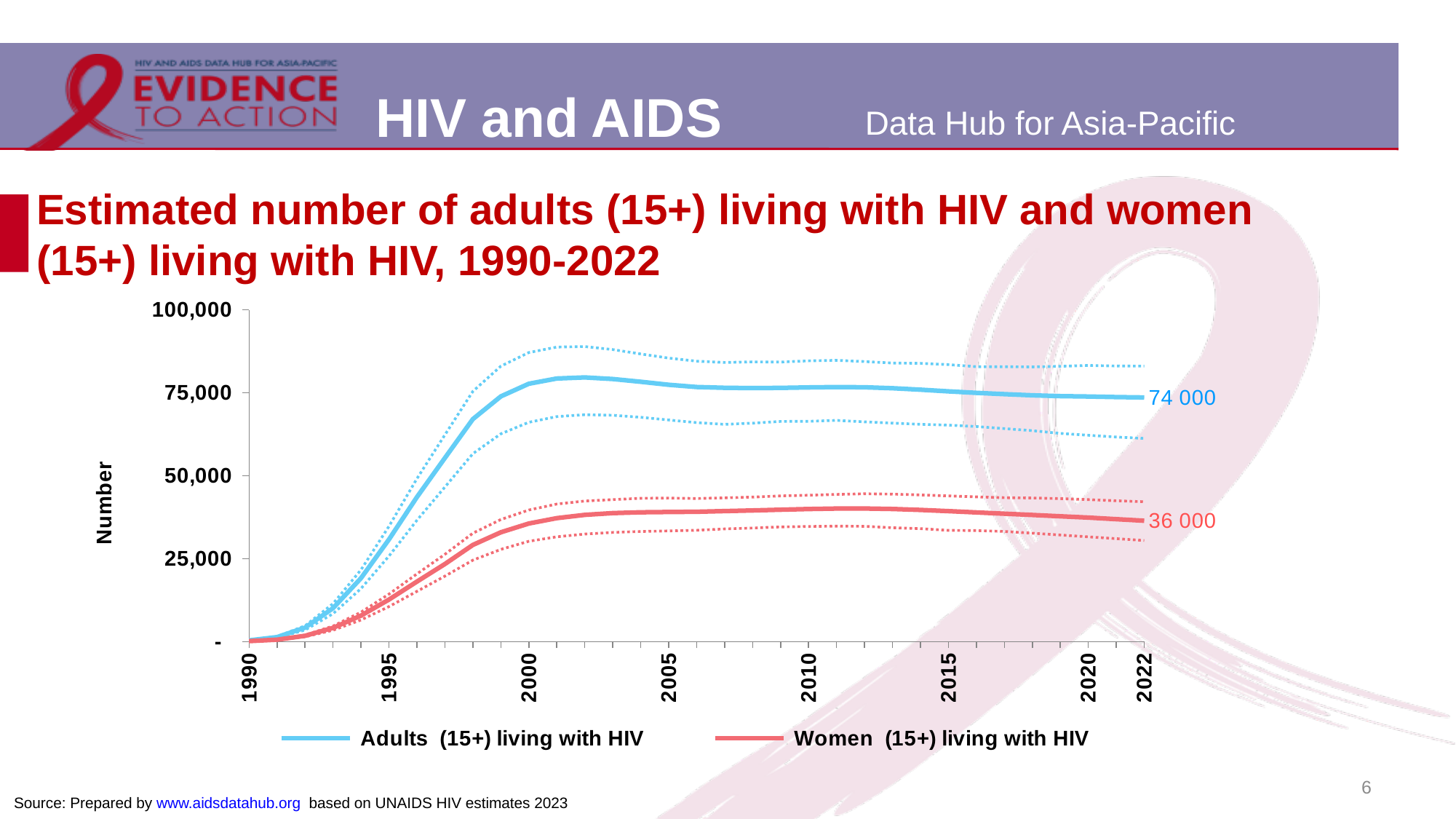
How many series does the legend list? 2 Is the value for adults (15+) living with HIV in 2000 greater or less than 50,000? greater In 2022, which series has the larger value: adults (15+) living with HIV or women (15+) living with HIV? Adults (15+) living with HIV What is the estimated number of women (15+) living with HIV in 2022? 36 000 How does the number of adults (15+) living with HIV change between 1990 and 2000? It rises What kind of chart is shown on the slide? Line chart Is the value for women (15+) living with HIV in 2010 greater or less than 50,000? less Is the value for adults (15+) living with HIV in 1995 greater or less than 50,000? less Which colour represents women (15+) living with HIV in the chart? Red What is the estimated number of adults (15+) living with HIV in 2022? 74 000 What is the difference between the 2022 values for adults (15+) living with HIV and women (15+) living with HIV? 38 000 What is the label of the y axis? Number